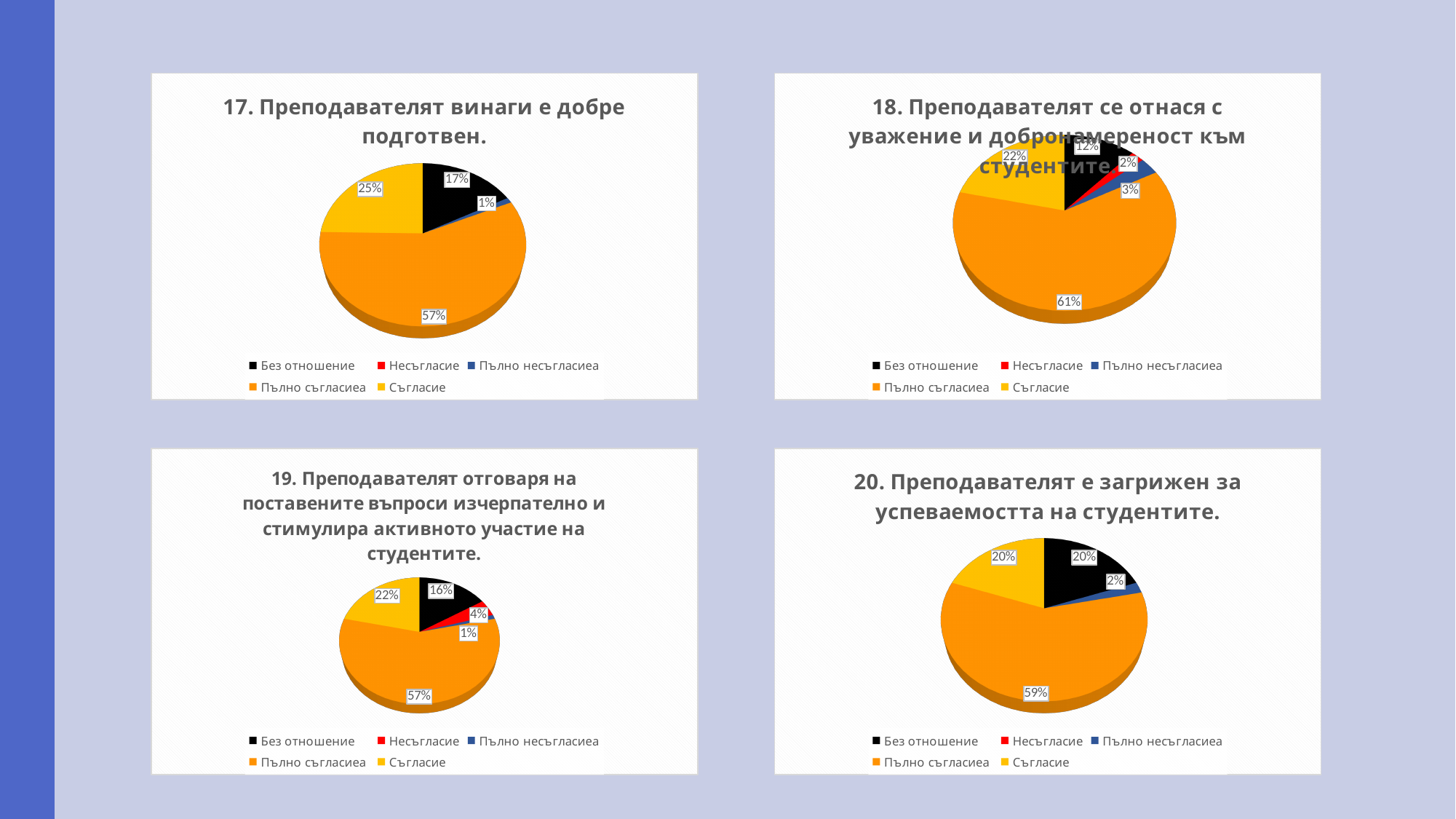
In chart 19 ("Преподавателят отговаря на поставените въпроси..."), which labelled category has the smallest slice? Пълно несъгласиеа In chart 20 ("Преподавателят е загрижен за успеваемостта на студентите."), what share is labelled for the "Пълно съгласиеа" slice? 59% In chart 17 ("Преподавателят винаги е добре подготвен."), which is larger: the "Без отношение" slice or the "Съгласие" slice? Съгласие How many entries does the legend of chart 20 ("Преподавателят е загрижен за успеваемостта на студентите.") list? 5 In chart 17 ("Преподавателят винаги е добре подготвен."), what share is labelled for the "Съгласие" slice? 25% What type of chart is used for chart 19 ("Преподавателят отговаря на поставените въпроси...")? Pie chart In chart 18 ("Преподавателят се отнася с уважение..."), what share is labelled for the "Без отношение" slice? 12% In chart 17 ("Преподавателят винаги е добре подготвен."), what share is labelled for the "Пълно съгласиеа" slice? 57% In chart 18 ("Преподавателят се отнася с уважение..."), what share is labelled for the "Пълно съгласиеа" slice? 61% In chart 20 ("Преподавателят е загрижен за успеваемостта на студентите."), which category has the largest slice? Пълно съгласиеа In chart 18 ("Преподавателят се отнася с уважение..."), what is the difference between the "Пълно съгласиеа" share and the "Съгласие" share? 39% In chart 19 ("Преподавателят отговаря на поставените въпроси..."), what share is labelled for the "Несъгласие" slice? 4%